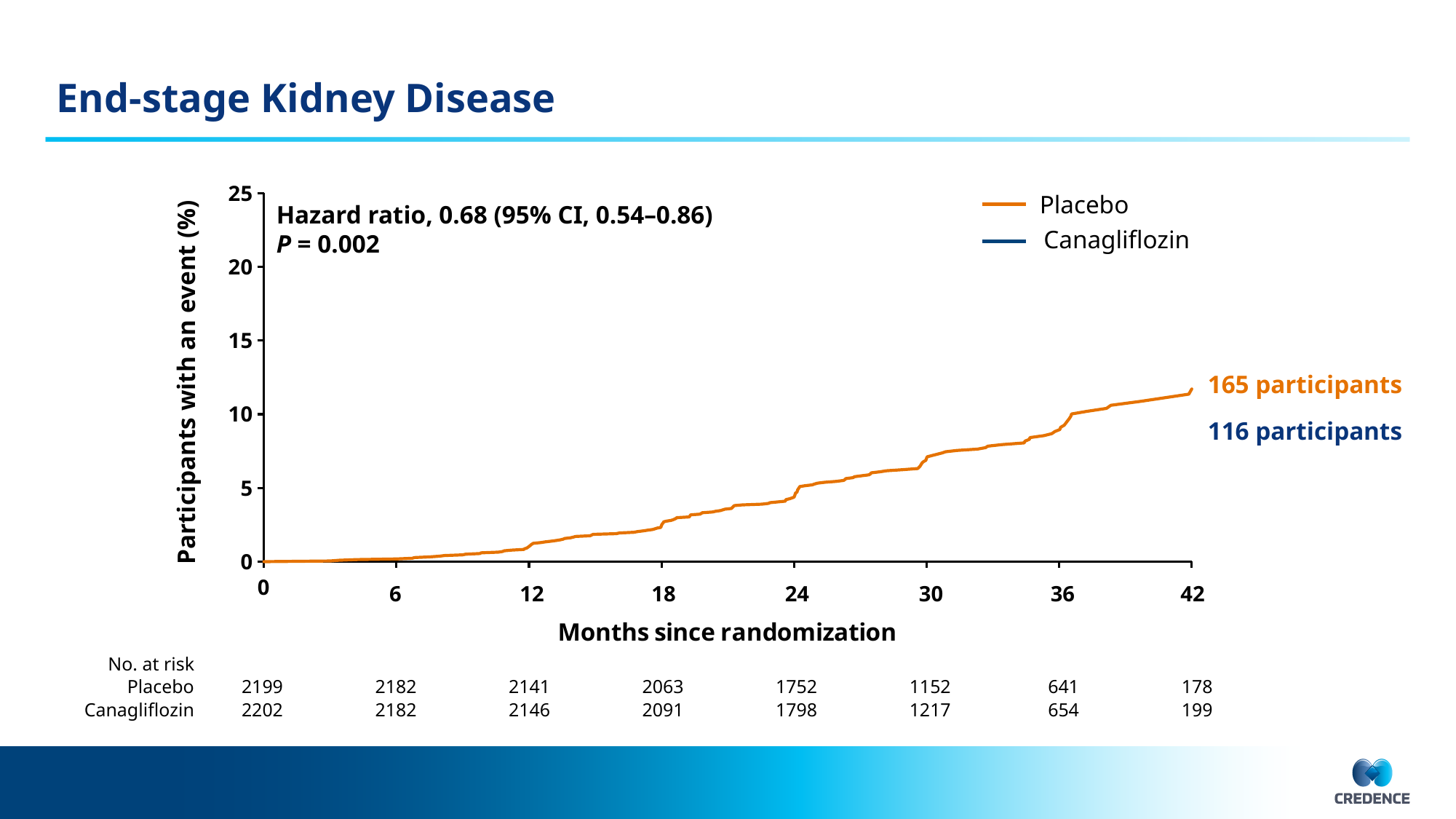
What is the difference between the number at risk for Canagliflozin and Placebo at 18 months? 28 Is the Placebo value at 42 months greater or less than 10%? greater How many participants had an event in the Placebo group, according to the label on the chart? 165 participants What kind of chart is shown on the slide? line chart Does the Placebo line rise or fall as months since randomization increase? rises Which two series are listed in the legend? Placebo and Canagliflozin What is the number at risk for Canagliflozin at 42 months? 199 How many participants had an event in the Canagliflozin group, according to the label on the chart? 116 participants What P value is shown on the chart? P = 0.002 What is the hazard ratio shown on the chart? 0.68 (95% CI, 0.54–0.86) How many series does the legend list? 2 What is the number at risk for Placebo at 24 months? 1752